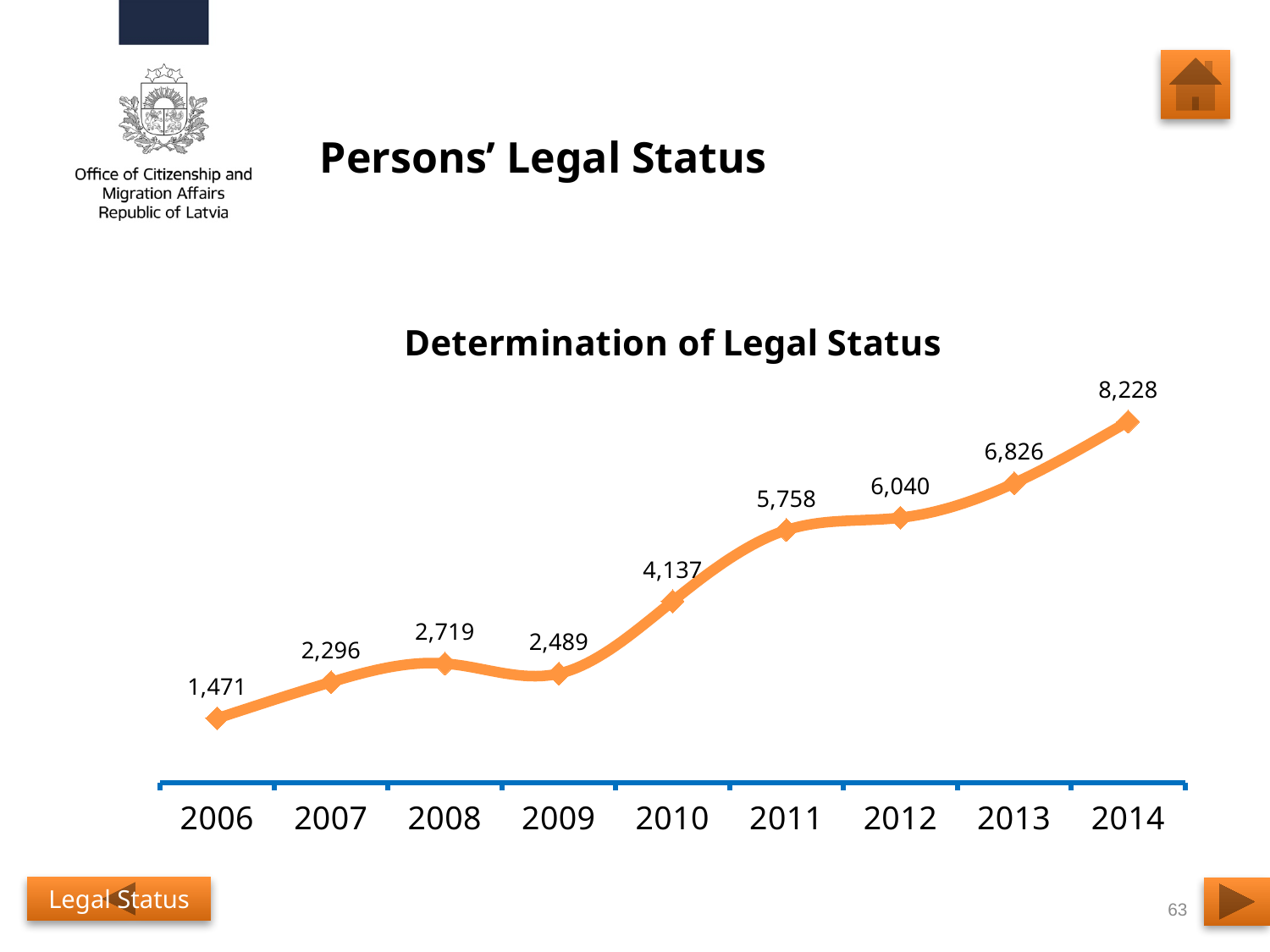
What is the title of the chart? Determination of Legal Status What is the difference between the values for 2008 and 2009? 230 What is the difference between the values for 2014 and 2013? 1,402 What is the value for 2013? 6,826 What kind of chart is shown? line chart Which is larger, the value for 2008 or the value for 2009? 2008 What is the value for 2010? 4,137 How many years are plotted on the chart? 9 Do the values generally rise or fall from 2006 to 2014? rise What is the value for 2006? 1,471 Which year has the highest value? 2014 Which year has the lowest value? 2006